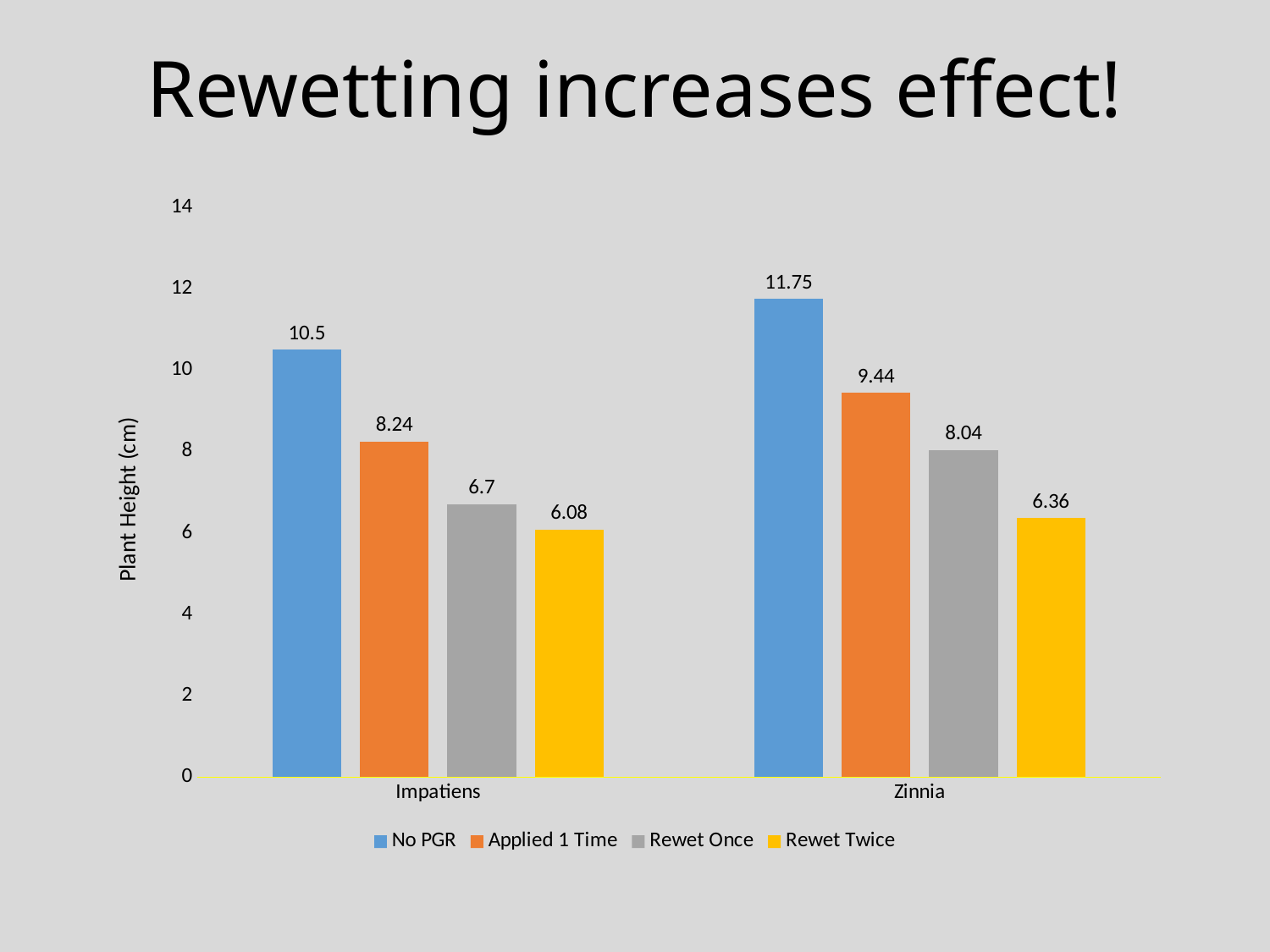
How many series does the legend list? 4 Which is larger: the Rewet Once value for Impatiens or the Rewet Once value for Zinnia? Zinnia What is the plant height for Zinnia with Rewet Twice? 6.36 How many categories are shown on the x axis? 2 What kind of chart is shown on the slide? Bar chart What is the plant height for Zinnia with Applied 1 Time? 9.44 What is the plant height for Impatiens with No PGR? 10.5 What is the difference in plant height between No PGR and Rewet Twice for Impatiens? 4.42 What is the label of the y axis? Plant Height (cm) Which series has the lowest plant height for Impatiens? Rewet Twice What is the difference in plant height between Applied 1 Time and Rewet Once for Zinnia? 1.4 Which series has the highest plant height for Zinnia? No PGR